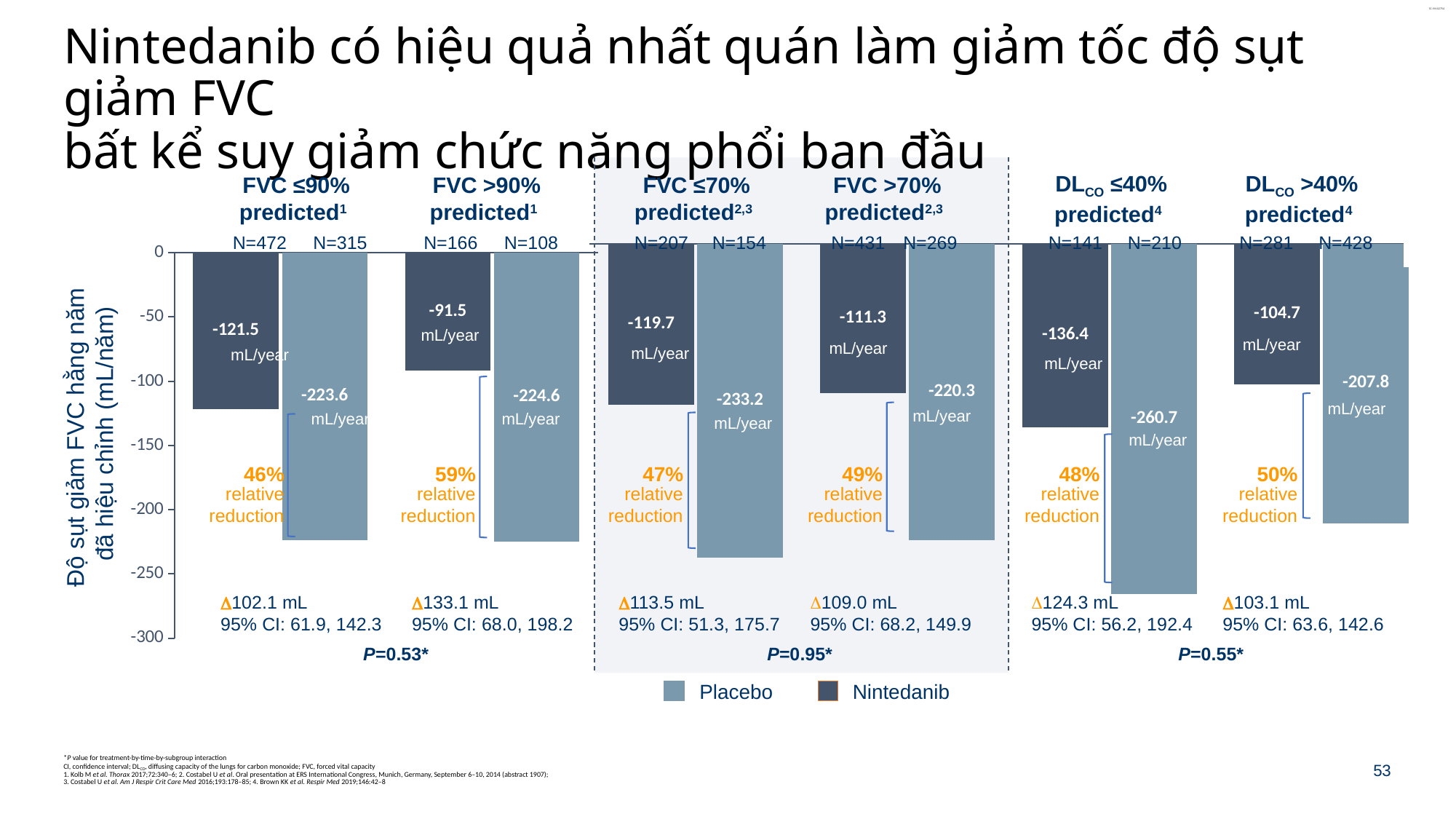
What kind of chart is shown on the slide? Bar chart What is the difference (Δ) between Placebo and Nintedanib in the FVC ≤70% predicted subgroup? 113.5 mL What is the annual FVC decline for Nintedanib in the FVC ≤90% predicted subgroup? -121.5 mL/year Which series is shown in the darker blue colour in the legend? Nintedanib What relative reduction is shown for the FVC >90% predicted subgroup? 59% In which subgroup does the Nintedanib bar show the smallest annual FVC decline? FVC >90% predicted What is the annual FVC decline for Placebo in the DLCO ≤40% predicted subgroup? -260.7 mL/year How many subgroups are shown on the x axis of the chart? 6 How many series does the legend list? 2 Which has a larger annual FVC decline in the FVC >70% predicted subgroup, Nintedanib or Placebo? Placebo In which subgroup does the Placebo bar show the largest annual FVC decline? DLCO ≤40% predicted What is the 95% CI for the difference in the DLCO >40% predicted subgroup? 63.6, 142.6